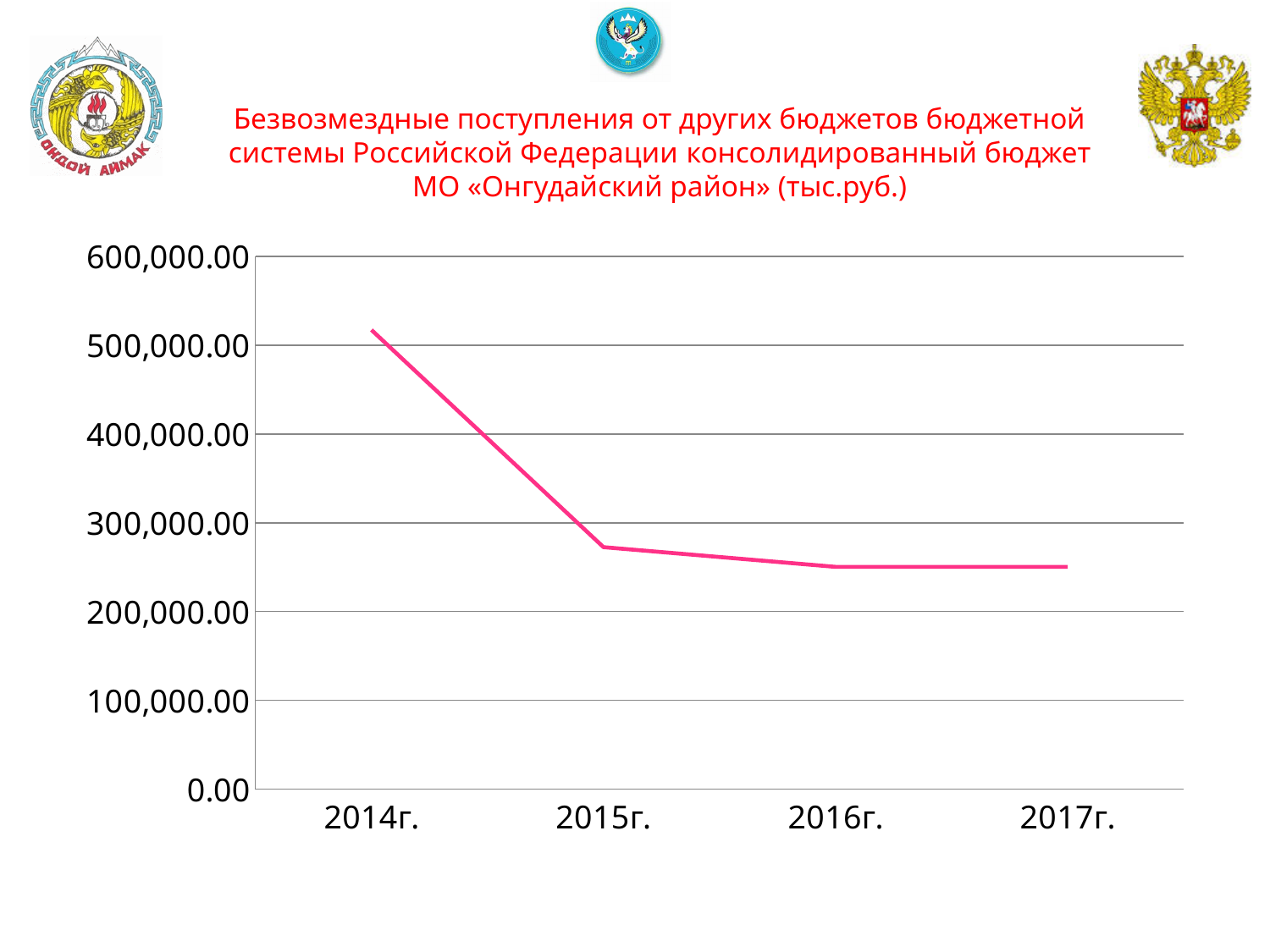
Is the value for 2015г. greater or less than 300,000.00? less Is the value for 2016г. greater or less than 200,000.00? greater What kind of chart is shown on the slide? line chart Which is larger, the value for 2014г. or the value for 2015г.? 2014г. What is the unit of measurement given in the chart title? тыс.руб. Is the value for 2017г. greater or less than 300,000.00? less How many years are plotted on the x axis of the chart? 4 Which is larger, the value for 2014г. or the value for 2017г.? 2014г. Which year has the highest value on the chart? 2014г. Do the values rise or fall from 2014г. to 2017г.? fall What colour is the line on the chart? pink